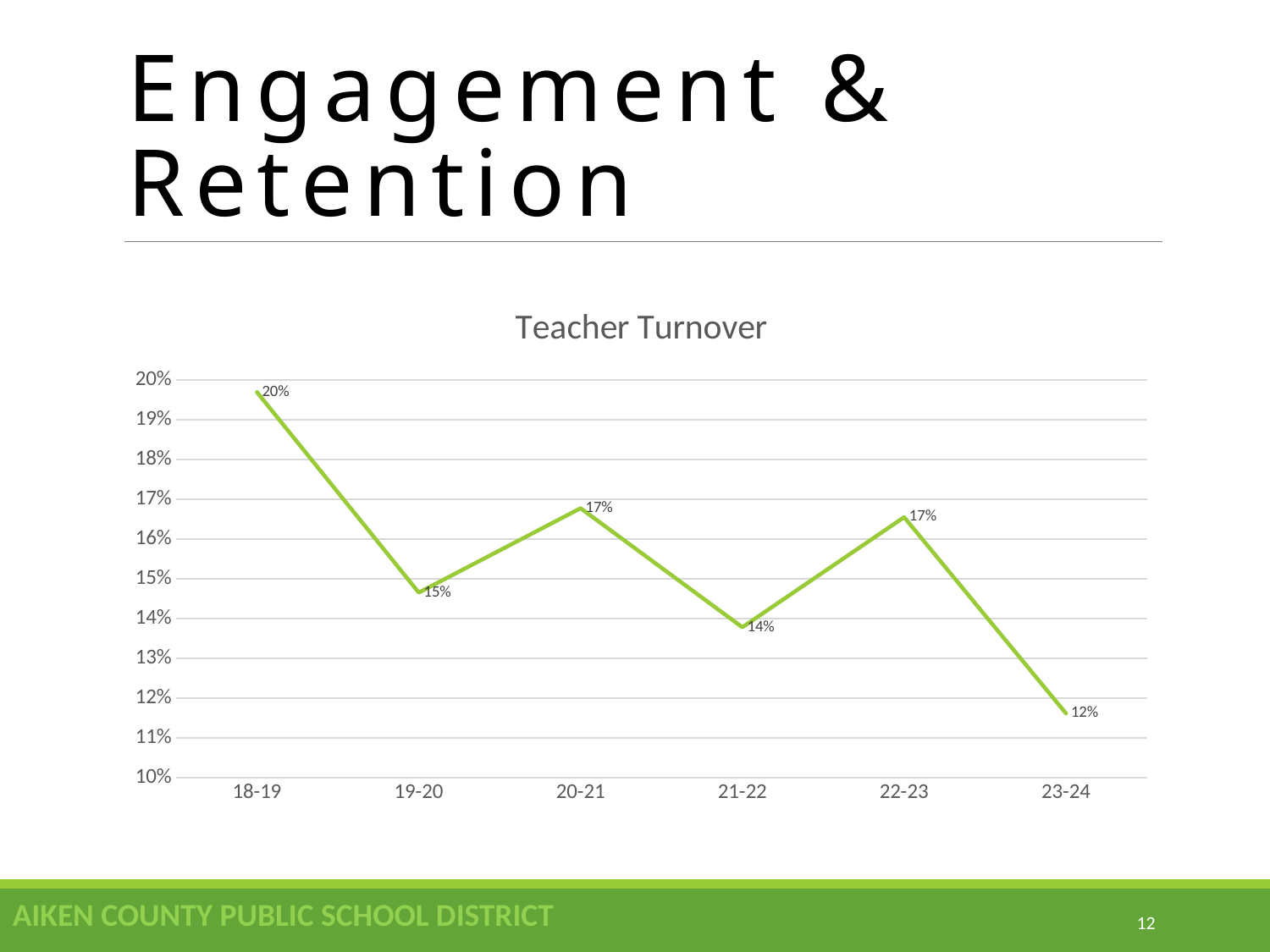
How many school years are plotted on the Teacher Turnover chart? 6 What kind of chart is used to show Teacher Turnover? Line chart Which year has the lowest teacher turnover? 23-24 What is the teacher turnover value for 18-19? 20% Is the teacher turnover value for 22-23 greater or less than 15%? greater Overall, does teacher turnover rise or fall from 18-19 to 23-24? Fall What is the teacher turnover value for 19-20? 15% What is the teacher turnover value for 21-22? 14% What is the difference between the teacher turnover in 18-19 and in 23-24? 8% What is the teacher turnover value for 23-24? 12% Which year has the highest teacher turnover? 18-19 Which year has higher teacher turnover, 19-20 or 21-22? 19-20